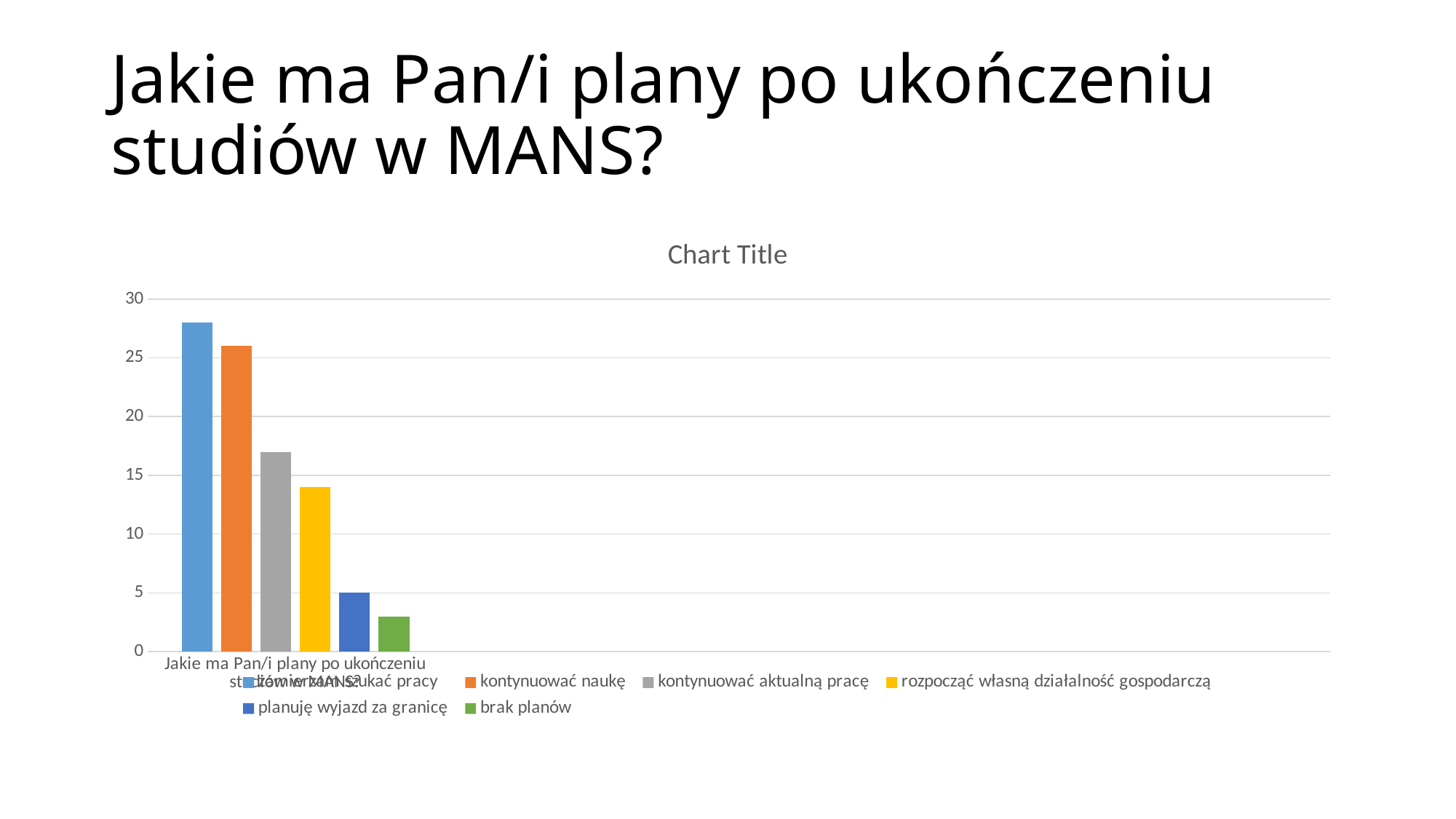
Which is larger: 'kontynuować naukę' or 'kontynuować aktualną pracę'? kontynuować naukę Is the value of the first (light blue) bar greater or less than 25? greater Is the value for 'rozpocząć własną działalność gospodarczą' greater or less than 15? less Which is larger: 'rozpocząć własną działalność gospodarczą' or 'planuję wyjazd za granicę'? rozpocząć własną działalność gospodarczą What kind of chart is shown on the slide? bar chart Is the value for 'brak planów' greater or less than 5? less How many series does the legend list? 6 What is the value for 'planuję wyjazd za granicę'? 5 What colour is the bar for 'brak planów'? green Which series has the lowest value? brak planów